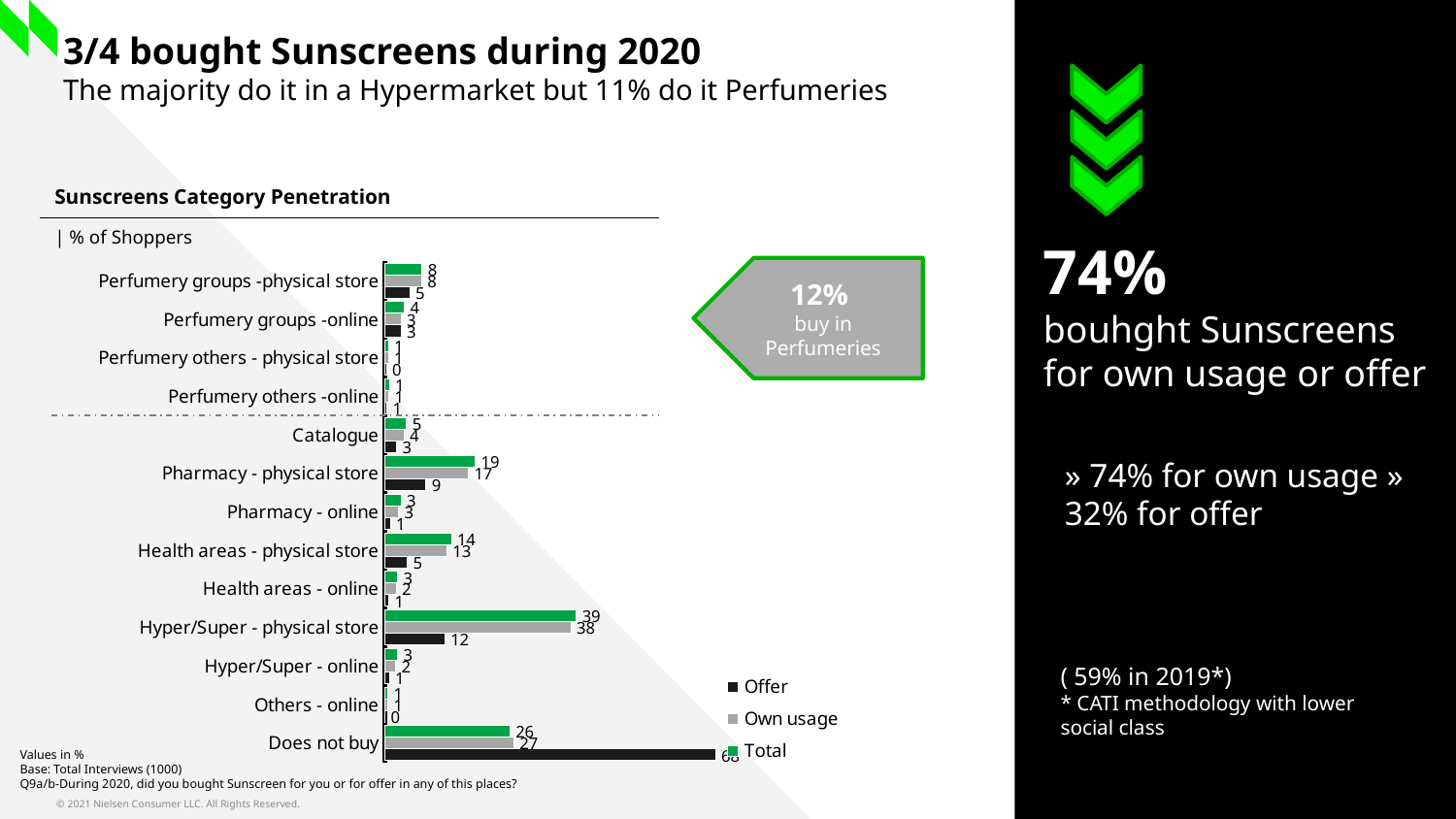
What is the Total value for Hyper/Super - physical store? 39 Which colour represents the Total series in the legend? Green How many series does the legend of the Sunscreens Category Penetration chart list? 3 Which has a higher Total value: Pharmacy - physical store or Health areas - physical store? Pharmacy - physical store What is the difference between the Total and Own usage values for Pharmacy - physical store? 2 What kind of chart is shown under the title 'Sunscreens Category Penetration'? Bar chart Which category has the highest Total value? Hyper/Super - physical store What is the Own usage value for Health areas - physical store? 13 What is the difference between the Total and Offer values for Hyper/Super - physical store? 27 What is the Own usage value for Does not buy? 27 How many store categories are plotted in the Sunscreens Category Penetration chart? 13 What is the Offer value for Pharmacy - physical store? 9